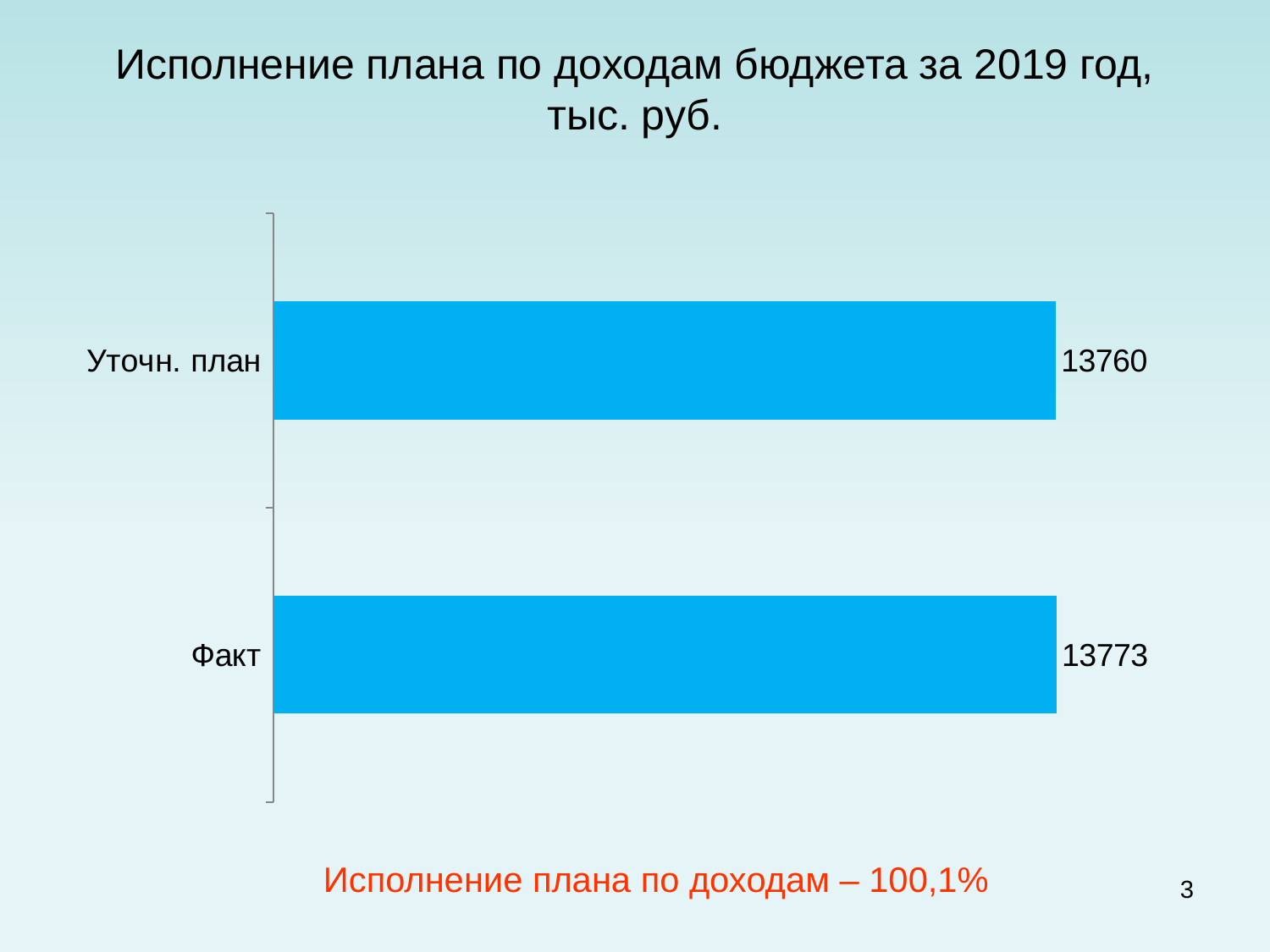
Which category has the highest value? Факт What is the title of the chart? Исполнение плана по доходам бюджета за 2019 год, тыс. руб. How many categories are shown in the chart? 2 What is the value for Уточн. план? 13760 What kind of chart is shown on the slide? Bar chart Which category has the lowest value? Уточн. план What percentage of plan execution for revenues is stated below the chart? 100,1% What is the value for Факт? 13773 Which category has the higher value, Уточн. план or Факт? Факт What is the difference between the values for Факт and Уточн. план? 13